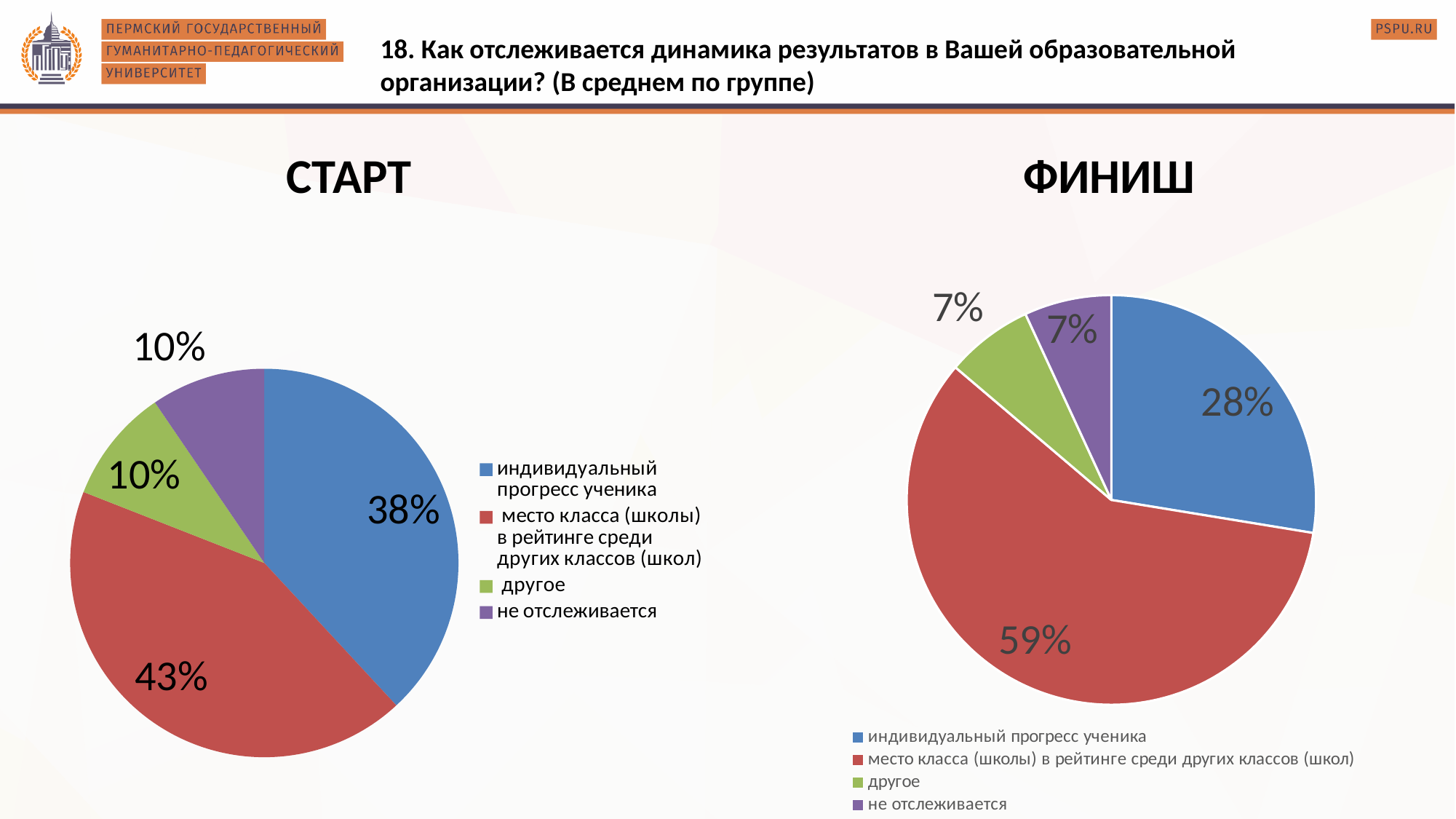
In the ФИНИШ pie chart, what share is labelled for 'другое'? 7% In the СТАРТ pie chart, what share is labelled for 'место класса (школы) в рейтинге среди других классов (школ)'? 43% How many categories does the legend of the ФИНИШ pie chart list? 4 In the ФИНИШ pie chart, which category has the largest slice? место класса (школы) в рейтинге среди других классов (школ) In the ФИНИШ pie chart, what is the difference between the shares for 'место класса (школы) в рейтинге' and 'индивидуальный прогресс ученика'? 31% In the СТАРТ pie chart, what is the difference between the shares for 'место класса (школы) в рейтинге' and 'индивидуальный прогресс ученика'? 5% In the ФИНИШ pie chart, what share is labelled for 'индивидуальный прогресс ученика'? 28% In the ФИНИШ pie chart, what share is labelled for 'место класса (школы) в рейтинге среди других классов (школ)'? 59% In the СТАРТ pie chart, what share is labelled for 'индивидуальный прогресс ученика'? 38% What type of chart is used for СТАРТ and ФИНИШ? Pie chart Which chart shows a larger share for 'индивидуальный прогресс ученика', СТАРТ or ФИНИШ? СТАРТ In the СТАРТ pie chart, which category has the largest slice? место класса (школы) в рейтинге среди других классов (школ)